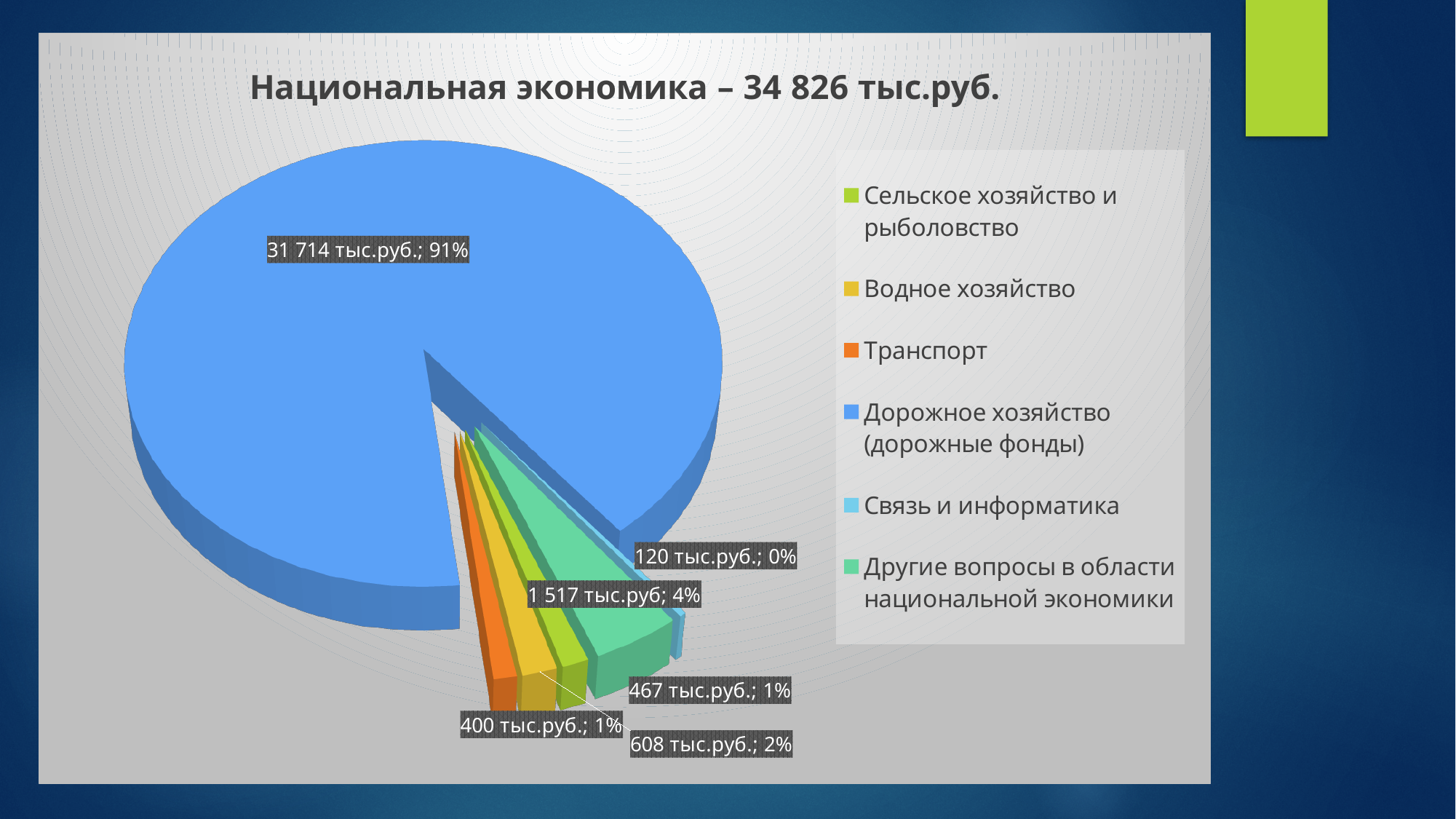
What share of the pie is labelled for Другие вопросы в области национальной экономики? 4% What is the difference between the value for Дорожное хозяйство (дорожные фонды) and the value for Другие вопросы в области национальной экономики? 30 197 тыс.руб. Which category has the largest slice? Дорожное хозяйство (дорожные фонды) How many categories does the legend list? 6 What value is shown for Дорожное хозяйство (дорожные фонды)? 31 714 тыс.руб. What value is shown for Связь и информатика? 120 тыс.руб. Which category has the smallest slice? Связь и информатика What kind of chart is shown on the slide? pie chart Which is larger, the value for Другие вопросы в области национальной экономики or the value for Связь и информатика? Другие вопросы в области национальной экономики What value is shown for Другие вопросы в области национальной экономики? 1 517 тыс.руб What is the title of the chart? Национальная экономика – 34 826 тыс.руб. What share of the pie does Дорожное хозяйство (дорожные фонды) take? 91%